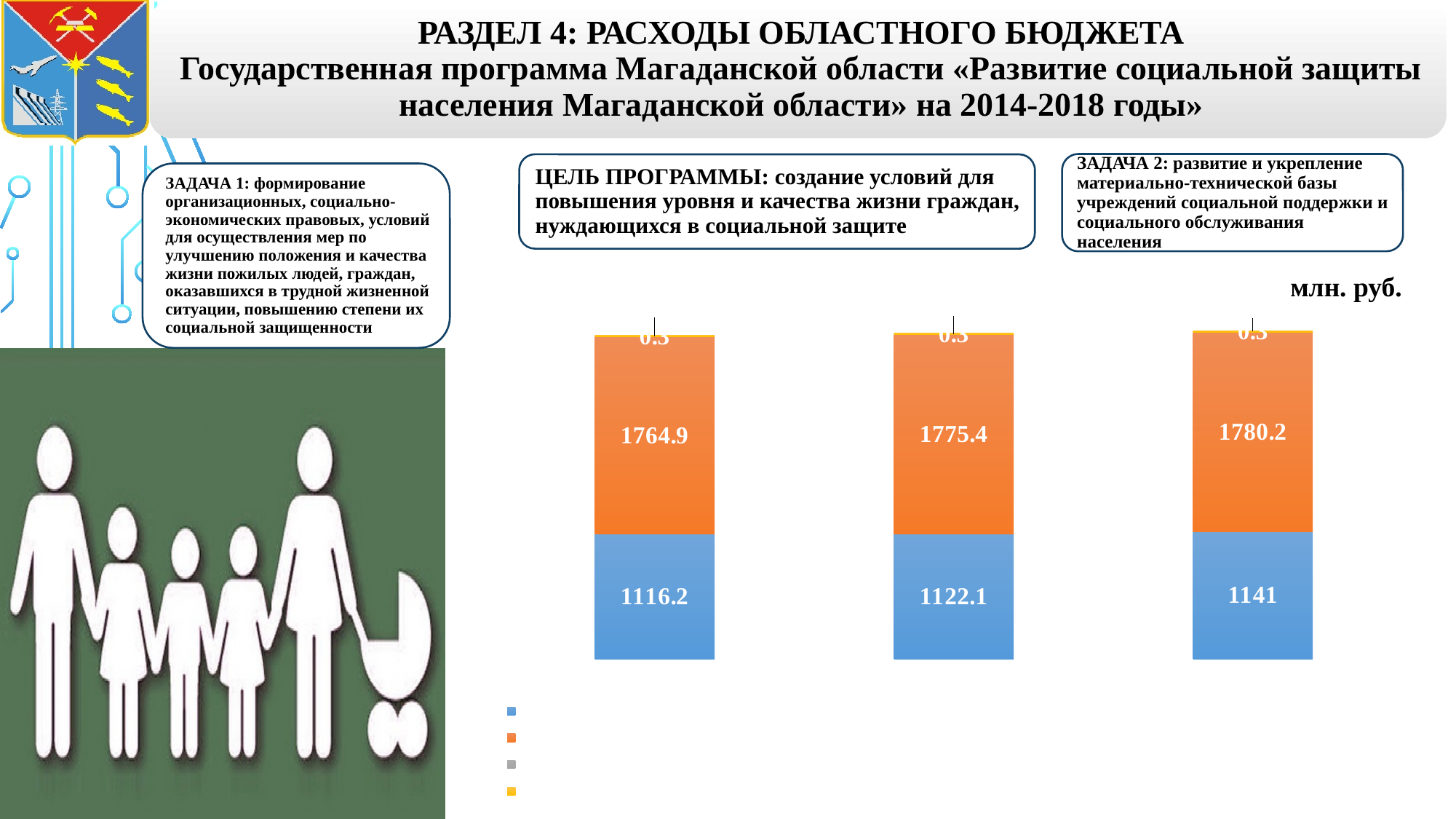
How many stacked bars does the chart contain? 3 What kind of chart is shown on the slide? bar chart What unit is indicated above the chart? млн. руб. Which bar has the highest blue segment value? the rightmost bar Which bar has the lowest orange segment value? the leftmost bar Do the blue segment values rise or fall from the left bar to the right bar? rise What is the difference between the orange segment values of the rightmost bar and the leftmost bar? 15.3 What is the value of the blue segment in the leftmost bar? 1116.2 What is the value of the orange segment in the rightmost bar? 1780.2 What is the value of the blue segment in the rightmost bar? 1141 How many colour entries does the chart legend show? 4 What is the value of the orange segment in the middle bar? 1775.4